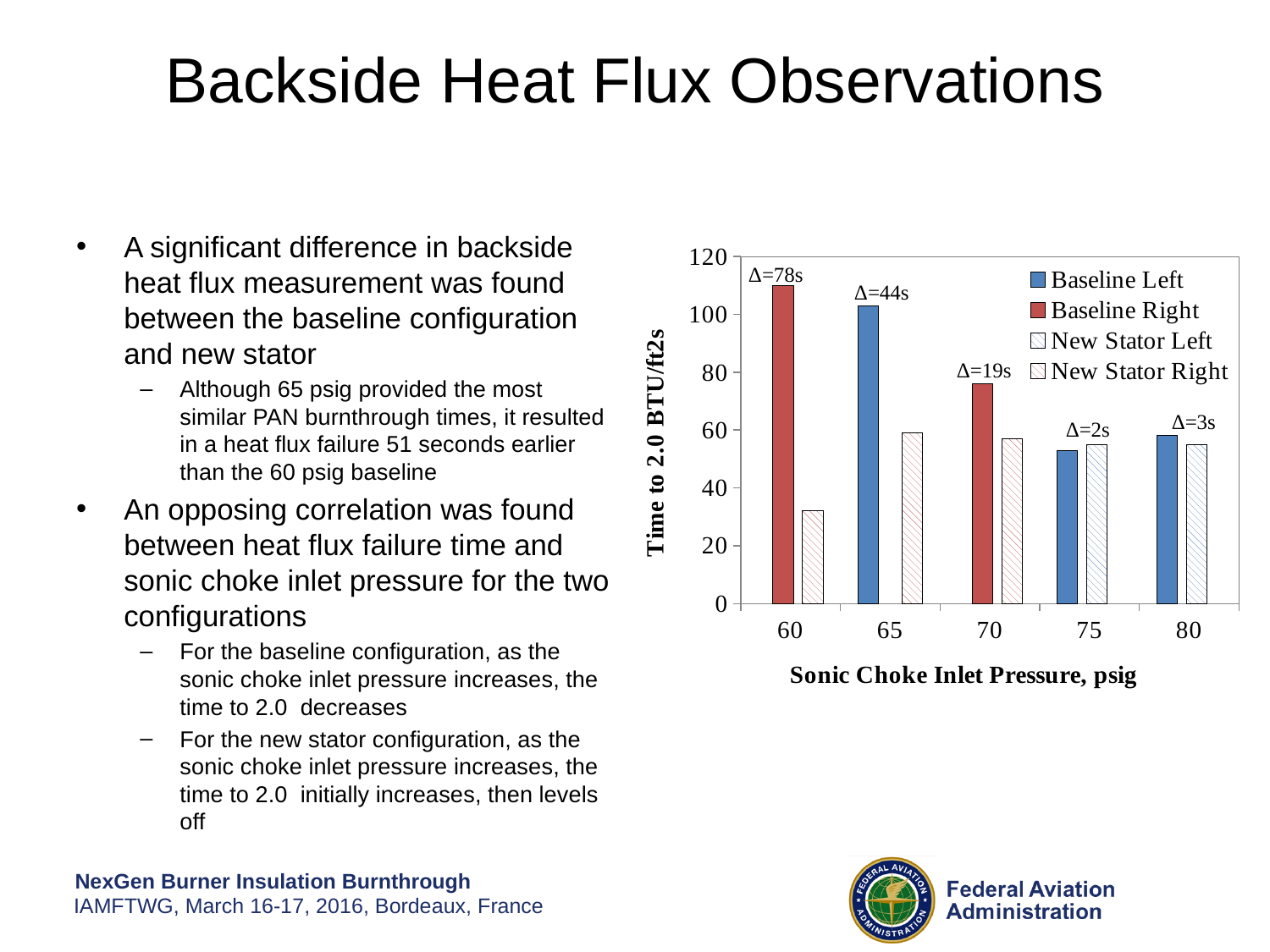
What is the Δ label shown above the bars at 65 psig? Δ=44s Which is larger at 70 psig, the baseline bar or the new stator bar? baseline How do the baseline bars change as sonic choke inlet pressure increases from 60 to 80 psig? they decrease Is the new stator bar at 60 psig greater or less than 40? less How many series does the chart legend list? 4 What is the Δ label shown above the bars at 60 psig? Δ=78s How many sonic choke inlet pressure categories are shown on the x axis? 5 What is the Δ label shown above the bars at 70 psig? Δ=19s What is the title of the chart's x axis? Sonic Choke Inlet Pressure, psig At which sonic choke inlet pressure is the Δ label the smallest? 75 What kind of chart is shown on the slide? bar chart Is the baseline bar at 60 psig greater or less than 100? greater